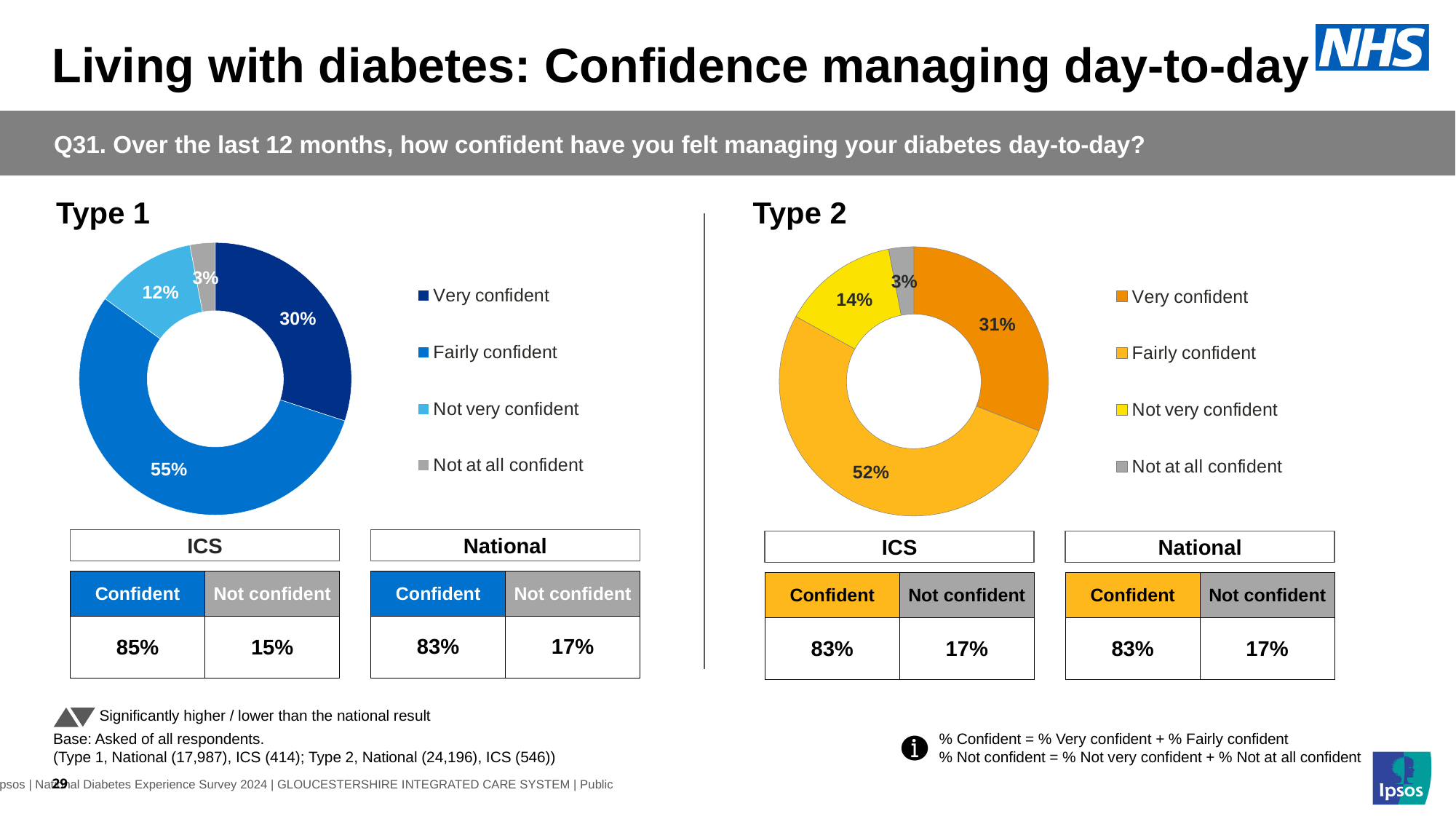
In the Type 2 chart, which is larger: the not very confident share or the not at all confident share? Not very confident In the Type 2 chart, which category has the largest share? Fairly confident In the Type 1 chart, what percentage of respondents were fairly confident? 55% In the Type 1 chart, what is the difference between the fairly confident and very confident shares? 25 percentage points What kind of chart is used for Type 1? Doughnut (pie) chart In the Type 1 chart, what colour represents the very confident category? Dark blue In the Type 2 chart, what is the difference between the not very confident share and the not at all confident share? 11 percentage points How many categories does the Type 2 chart show? 4 In the Type 2 chart, what percentage of respondents were very confident? 31% In the Type 1 chart, what percentage of respondents were not very confident? 12% In the Type 1 chart, which category has the smallest share? Not at all confident In the Type 2 chart, what colour represents the not very confident category? Yellow